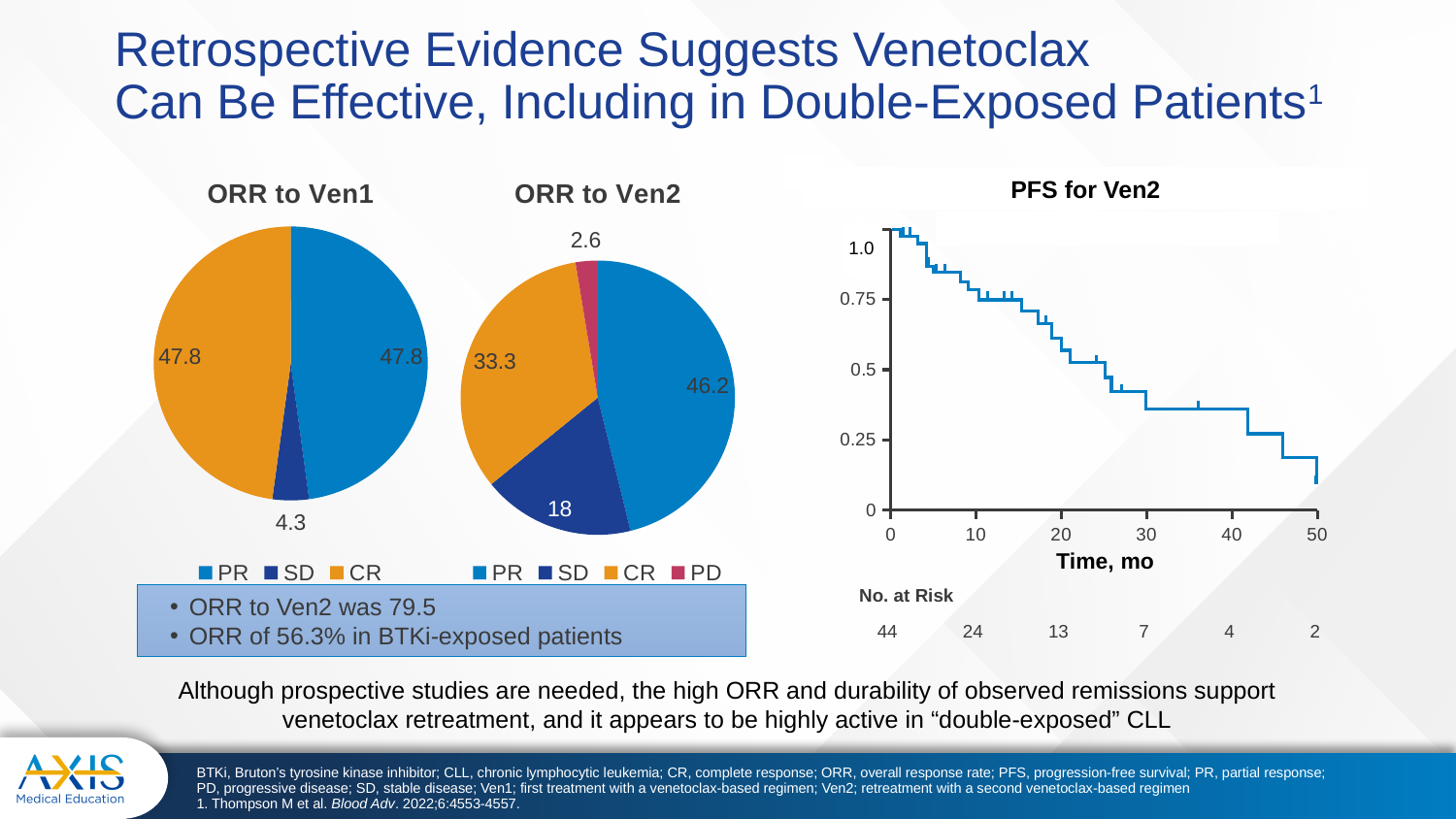
In the ORR to Ven2 pie chart, what is the value for PR? 46.2 What kind of chart is the PFS for Ven2 chart? line chart How many categories does the legend of the ORR to Ven2 pie chart list? 4 In the ORR to Ven1 pie chart, what is the value for SD? 4.3 In the PFS for Ven2 chart, do the values rise or fall as time increases? fall How many categories does the legend of the ORR to Ven1 pie chart list? 3 In the ORR to Ven2 pie chart, which category has the largest slice? PR In the PFS for Ven2 chart, is the value at 30 months greater or less than 0.5? less In the ORR to Ven1 pie chart, which category has the smallest slice? SD In the ORR to Ven2 pie chart, what is the value for PD? 2.6 In the ORR to Ven2 pie chart, which is larger, CR or SD? CR In the ORR to Ven2 pie chart, what is the difference between the CR value and the SD value? 15.3